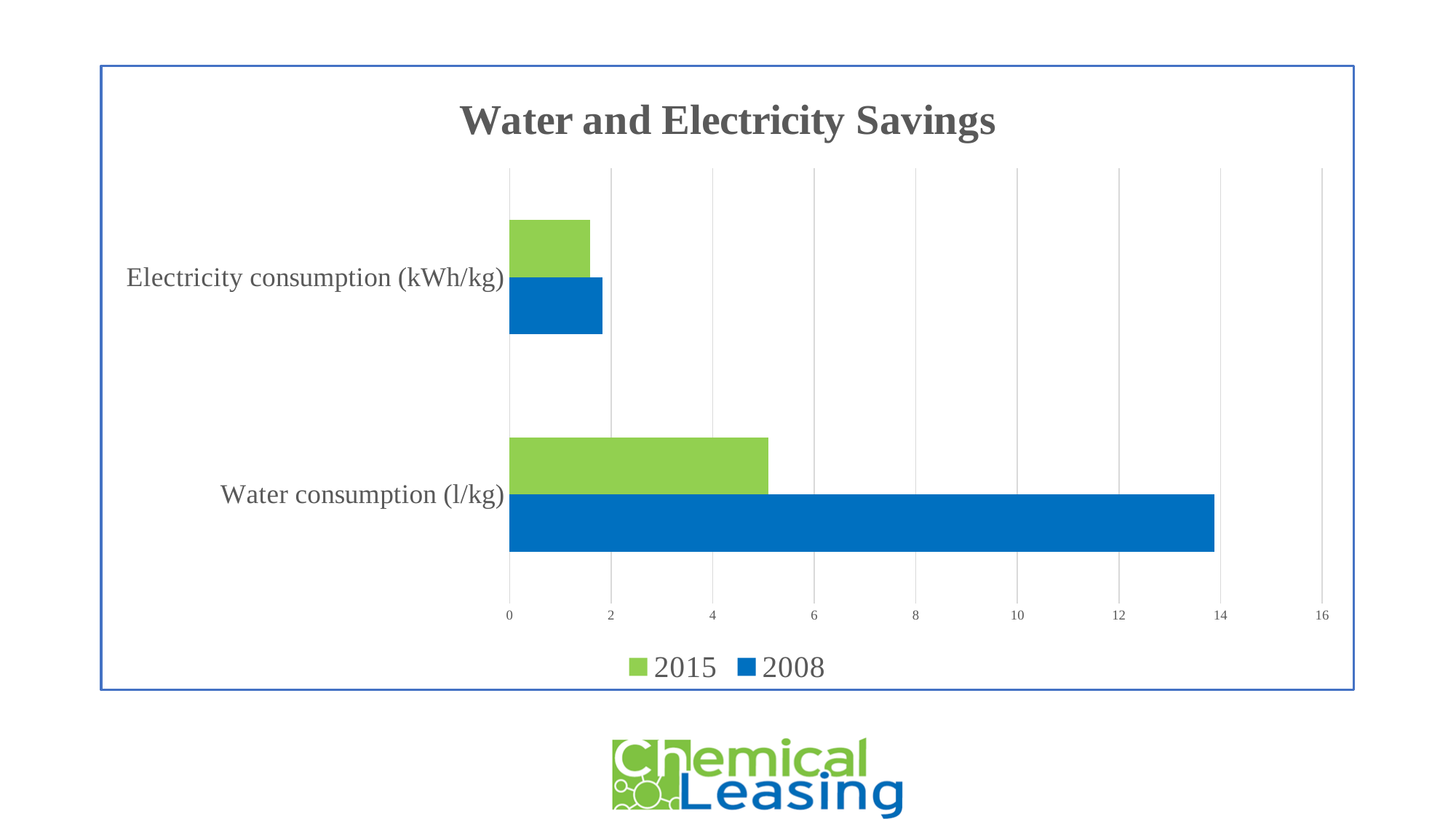
Is the 2015 value for Water consumption (l/kg) greater or less than 4? greater Which category has the highest 2008 value? Water consumption (l/kg) For Water consumption (l/kg), which year has the larger value, 2008 or 2015? 2008 Is the 2008 value for Water consumption (l/kg) greater or less than 12? greater Is the 2015 value for Water consumption (l/kg) greater or less than 6? less Which category has the lowest 2015 value? Electricity consumption (kWh/kg) What type of chart is shown on the slide? Bar chart How many categories are plotted on the chart? 2 What is the title of the chart? Water and Electricity Savings How many series does the legend list? 2 Which colour represents the 2015 series? Green